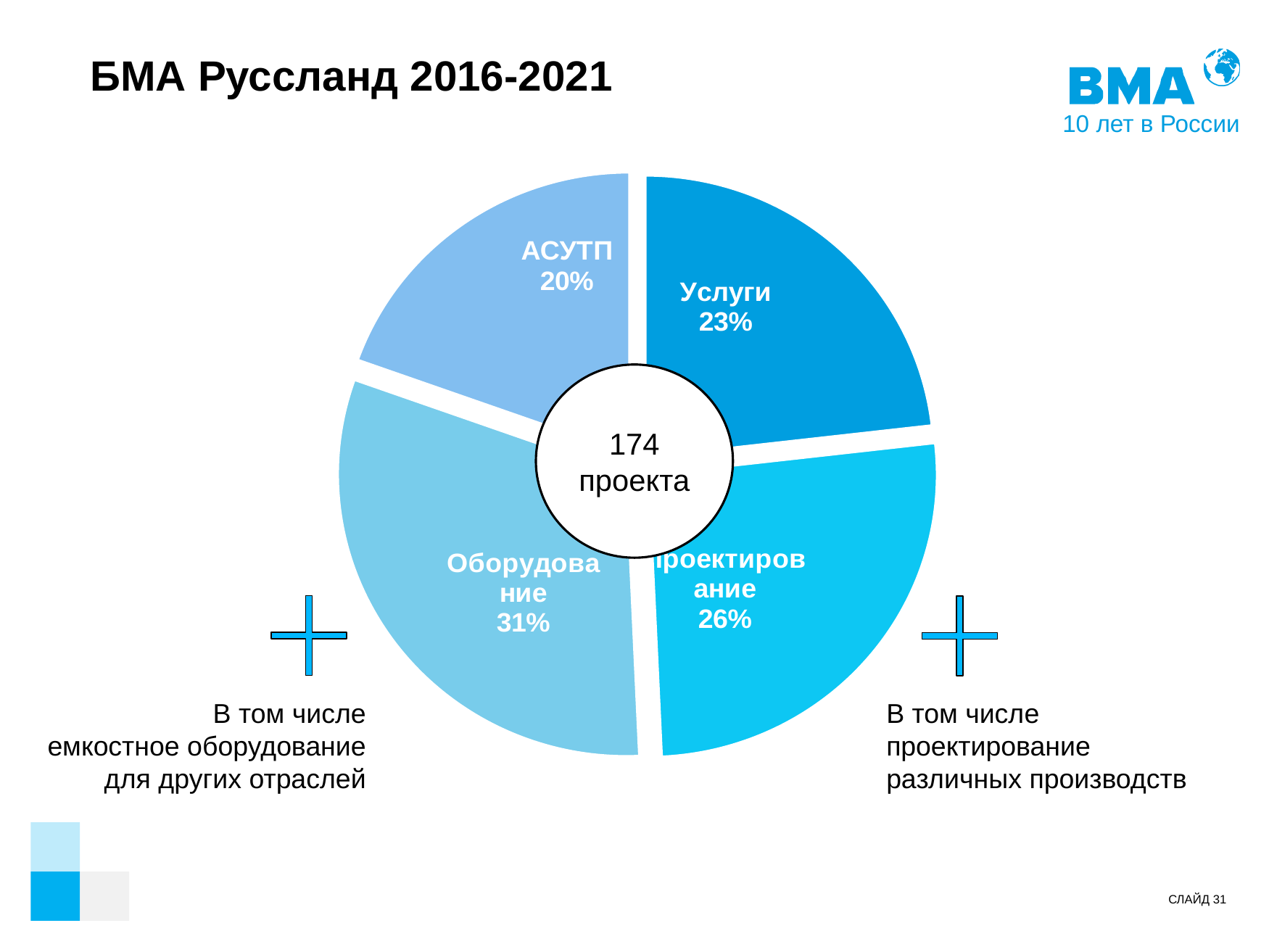
What share of the pie does Услуги have? 23% Which category has the largest slice of the pie? Оборудование What is the difference in percentage points between Оборудование and АСУТП? 11 How many slices does the pie chart have? 4 What kind of chart is shown on the slide? pie chart What share of the pie does Оборудование have? 31% What share of the pie does АСУТП have? 20% What is the title of the slide containing the pie chart? БМА Руссланд 2016-2021 Which category has the smallest slice of the pie? АСУТП What share of the pie does Проектирование have? 26% Which is larger, the share for Услуги or the share for Проектирование? Проектирование What total number of projects is shown in the centre of the pie chart? 174 проекта